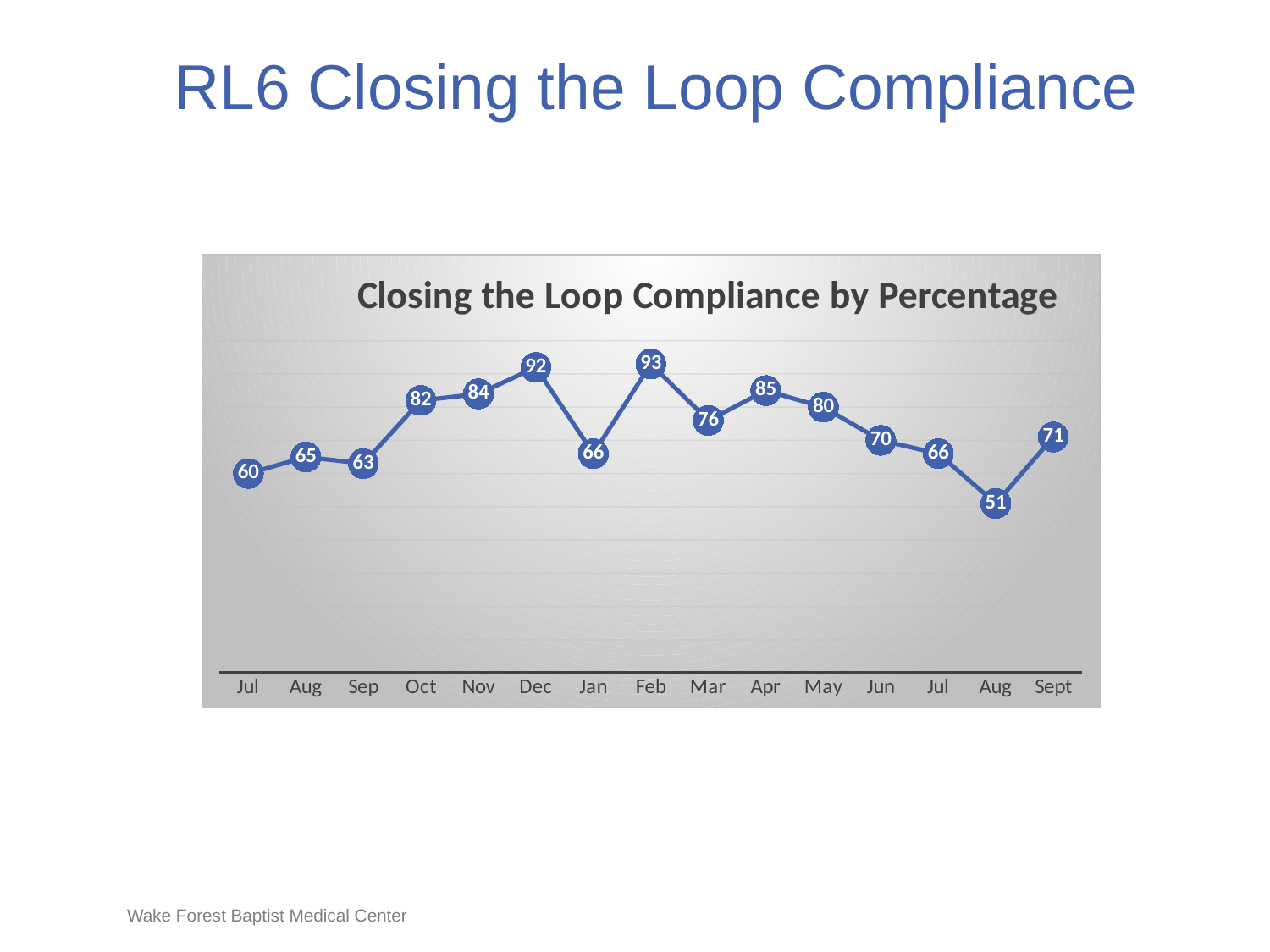
Do the values rise or fall from Sep to Dec? rise How many data points are plotted on the chart? 15 Which is larger, the value for Apr or the value for May? Apr Which month has the lowest value? Aug (the second Aug) What is the title of the chart? Closing the Loop Compliance by Percentage What type of chart is shown on the slide? line chart Which month has the highest value? Feb What is the value for Jan? 66 What is the value for the last point, Sept? 71 What is the value for Dec? 92 What is the difference between the values for Oct and Nov? 2 What is the difference between the values for Feb and Jan? 27